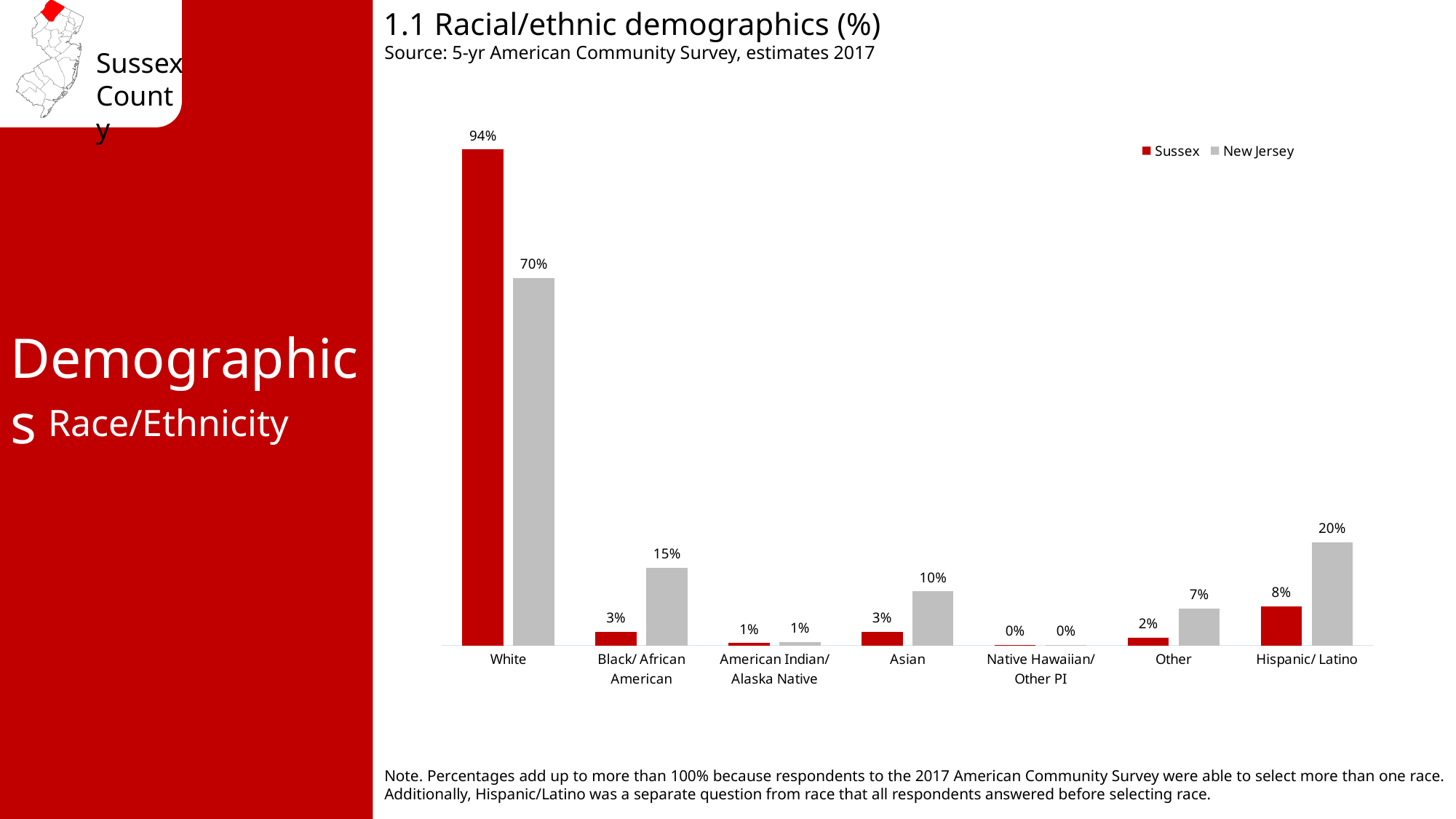
How many categories are shown on the x axis? 7 Which category has the highest New Jersey value? White What is the difference between the Sussex and New Jersey values for White? 24% What is the difference between the New Jersey and Sussex values for Hispanic/ Latino? 12% What is the New Jersey value for Black/ African American? 15% What kind of chart is shown? Bar chart What is the New Jersey value for Hispanic/ Latino? 20% What is the Sussex value for White? 94% How many series does the legend list? 2 Which category has the lowest Sussex value? Native Hawaiian/ Other PI Which is larger, the Sussex value for Other or the New Jersey value for Other? New Jersey What is the Sussex value for Asian? 3%